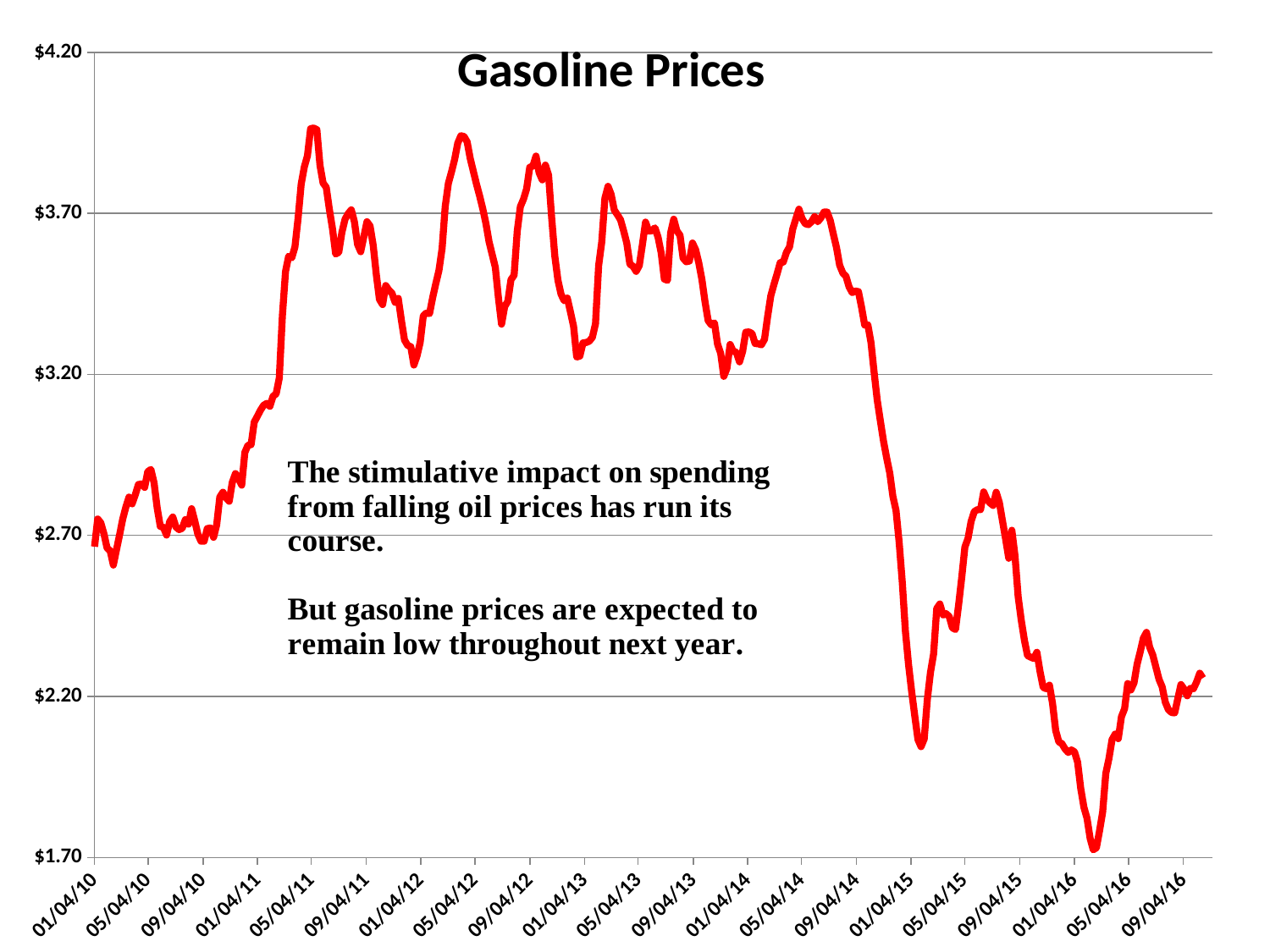
Is the value at 05/04/11 greater or less than $3.70? greater Is the value at 01/04/11 greater or less than $2.70? greater Is the value at 09/04/14 greater or less than $3.70? less What kind of chart is shown on the slide? line chart What is the title of the chart? Gasoline Prices Do gasoline prices rise or fall between 01/04/15 and 05/04/15? rise Do gasoline prices rise or fall between 09/04/14 and 01/04/15? fall How many date labels are shown on the x axis? 21